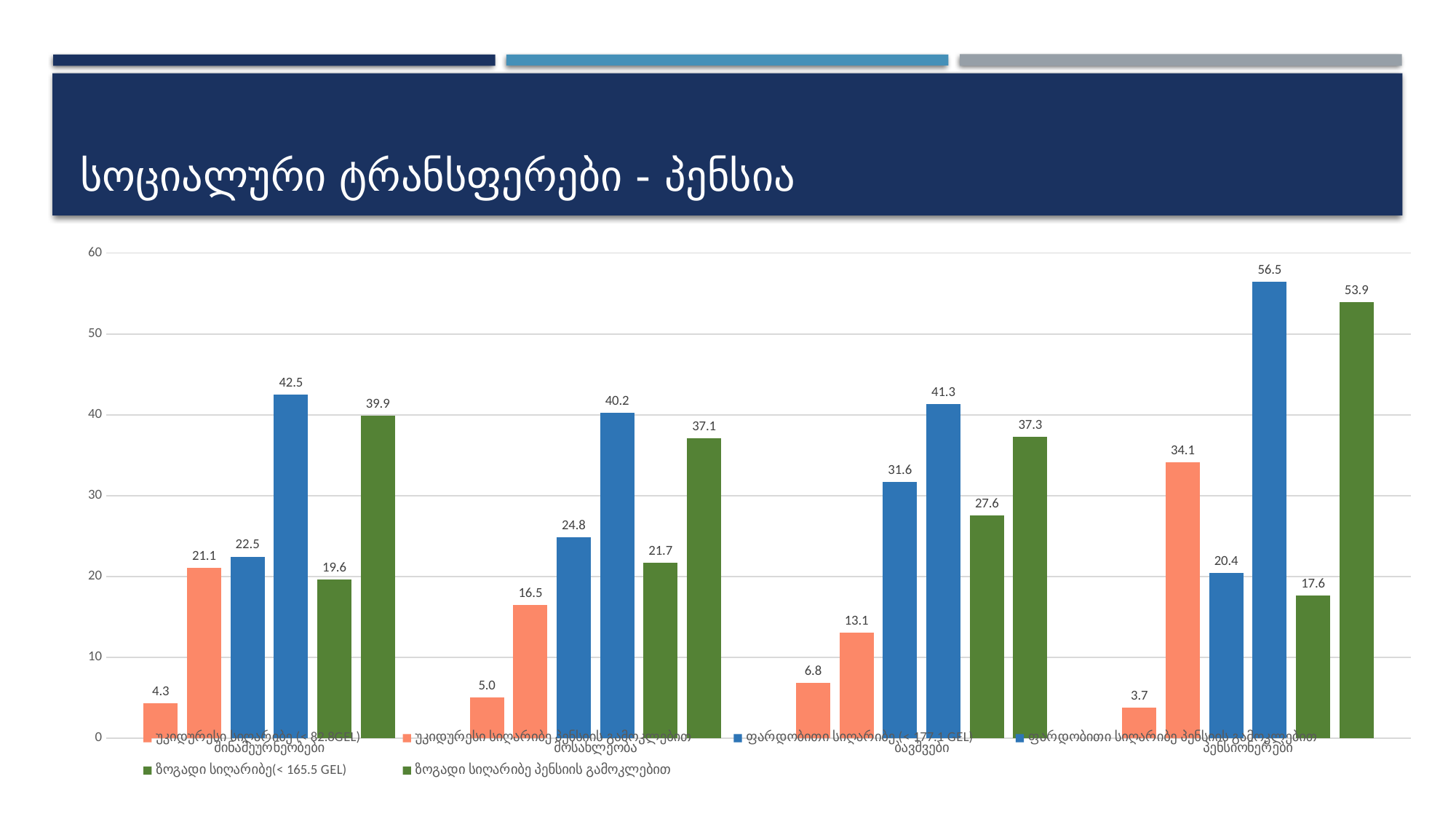
Is the value of the tallest green bar in the პენსიონერები group greater or less than 50? greater What is the lowest value shown in the პენსიონერები group? 3.7 How many category groups are shown along the x axis? 4 What is the title of the chart on the slide? სოციალური ტრანსფერები - პენსია What is the difference between the two blue bars in the მოსახლეობა group (40.2 and 24.8)? 15.4 What is the highest value shown in the პენსიონერები group? 56.5 How many series does the chart legend list? 6 What type of chart is shown on the slide? bar chart What is the value of the tallest bar in the ბავშვები group? 41.3 What is the difference between the two orange bars in the პენსიონერები group (34.1 and 3.7)? 30.4 What is the value of the first (leftmost) bar in the შინამეურნეობები group? 4.3 Which is larger: the tallest bar in the შინამეურნეობები group or the tallest bar in the მოსახლეობა group? შინამეურნეობები (42.5)